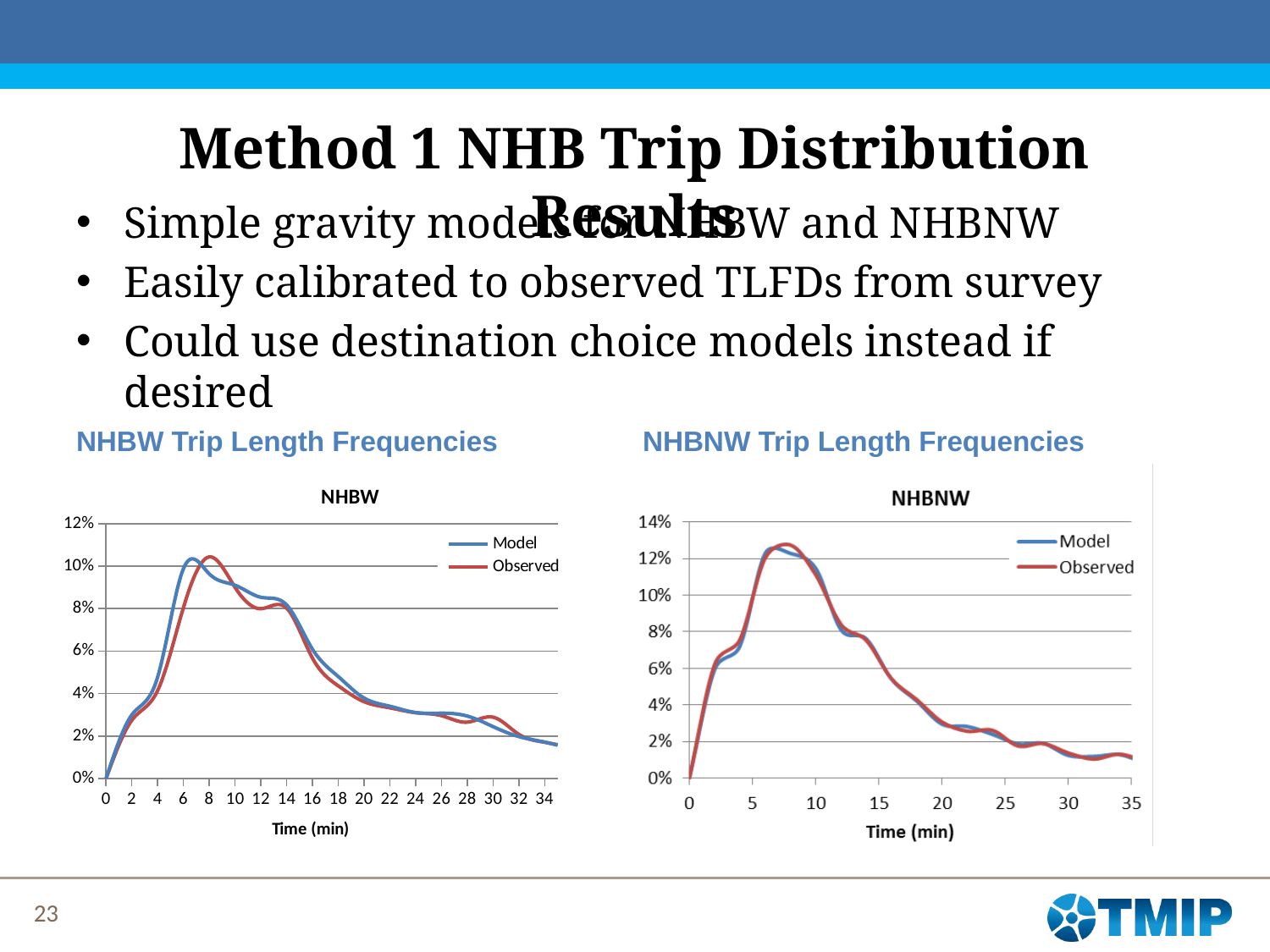
In the NHBW chart, is the Model value at 34 minutes greater or less than 2%? less What is the x-axis title of the NHBNW chart? Time (min) How many series does the legend of the NHBNW Trip Length Frequencies chart list? 2 What kind of chart is the NHBW Trip Length Frequencies chart on the left? line chart In the NHBNW chart, do the Model values rise or fall between 10 and 35 minutes? fall In the NHBNW chart, is the Model value at 30 minutes greater or less than 2%? less In the NHBW chart, which series is drawn in red? Observed In the NHBW chart, is the Observed value at 30 minutes greater or less than 2%? greater In the NHBW chart, do the Model values rise or fall between 14 and 34 minutes? fall In the NHBNW chart, do the Observed values rise or fall between 0 and 5 minutes? rise